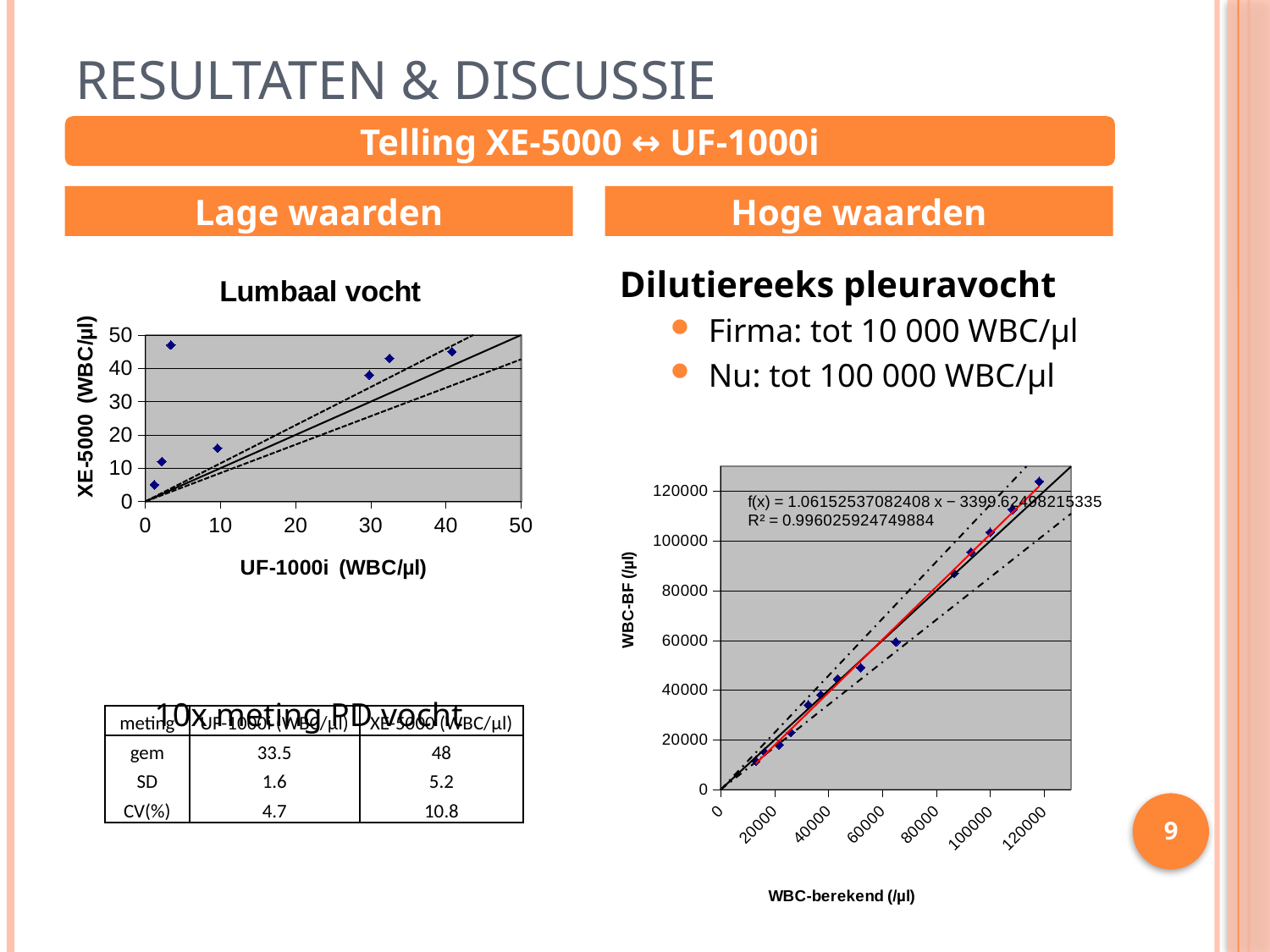
In the scatter chart on the right of the slide, do the WBC-BF values rise or fall as WBC-berekend increases? rise In the scatter chart on the right of the slide, what is the slope of the fitted line f(x) shown in the equation? 1.06152537082408 In the 'Lumbaal vocht' chart, is the XE-5000 value of the point at about 3 WBC/µl on the UF-1000i axis greater or less than 40? greater In the 'Lumbaal vocht' chart, how many data points are plotted? 7 What is the title of the chart on the left of the slide? Lumbaal vocht In the scatter chart on the right of the slide (WBC-BF vs WBC-berekend), what R² value is printed? 0.996025924749884 In the scatter chart on the right of the slide, what is the highest tick value shown on the y axis? 120000 In the 'Lumbaal vocht' chart, do the XE-5000 values generally rise or fall as the UF-1000i values increase? rise In the 'Lumbaal vocht' chart, is the XE-5000 value of the point at about 9 WBC/µl on the UF-1000i axis greater or less than 20? less In the 'Lumbaal vocht' chart, what is the highest tick value shown on the y axis? 50 What kind of chart is the 'Lumbaal vocht' chart on the left of the slide? scatter chart In the scatter chart on the right of the slide, what is the label of the y axis? WBC-BF (/µl)